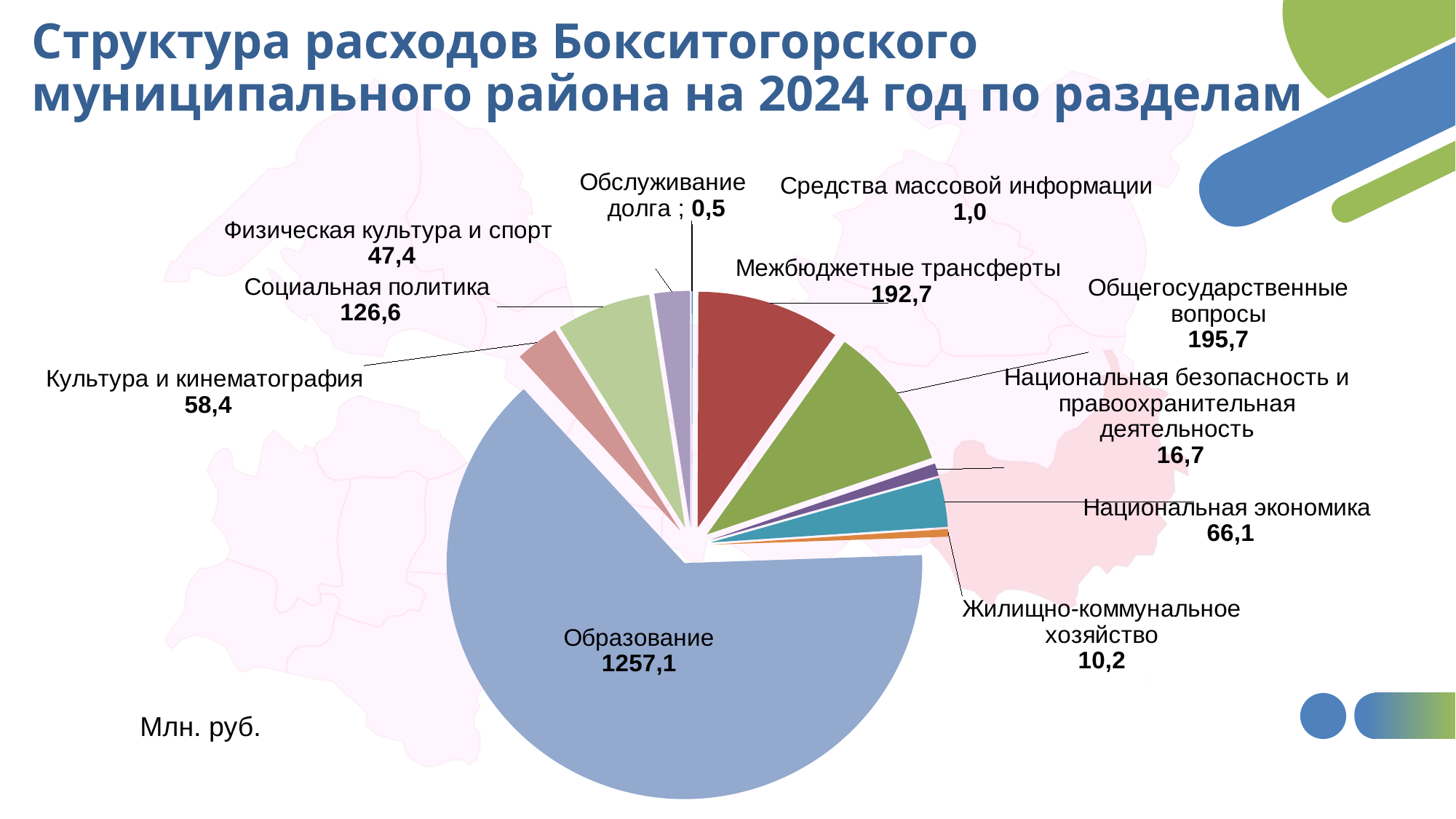
What is the value for Межбюджетные трансферты? 192,7 What type of chart is shown on the slide? Pie chart Which category has the largest value? Образование In what units are the values on the chart given? Млн. руб. How many categories (sections) does the pie chart show? 11 What is the difference between Социальная политика and Культура и кинематография? 68,2 Which category has the smallest value? Обслуживание долга Which is larger: Социальная политика or Национальная экономика? Социальная политика What is the value for Жилищно-коммунальное хозяйство? 10,2 What is the difference between Общегосударственные вопросы and Межбюджетные трансферты? 3,0 What is the value for Национальная безопасность и правоохранительная деятельность? 16,7 What is the value for Образование? 1257,1